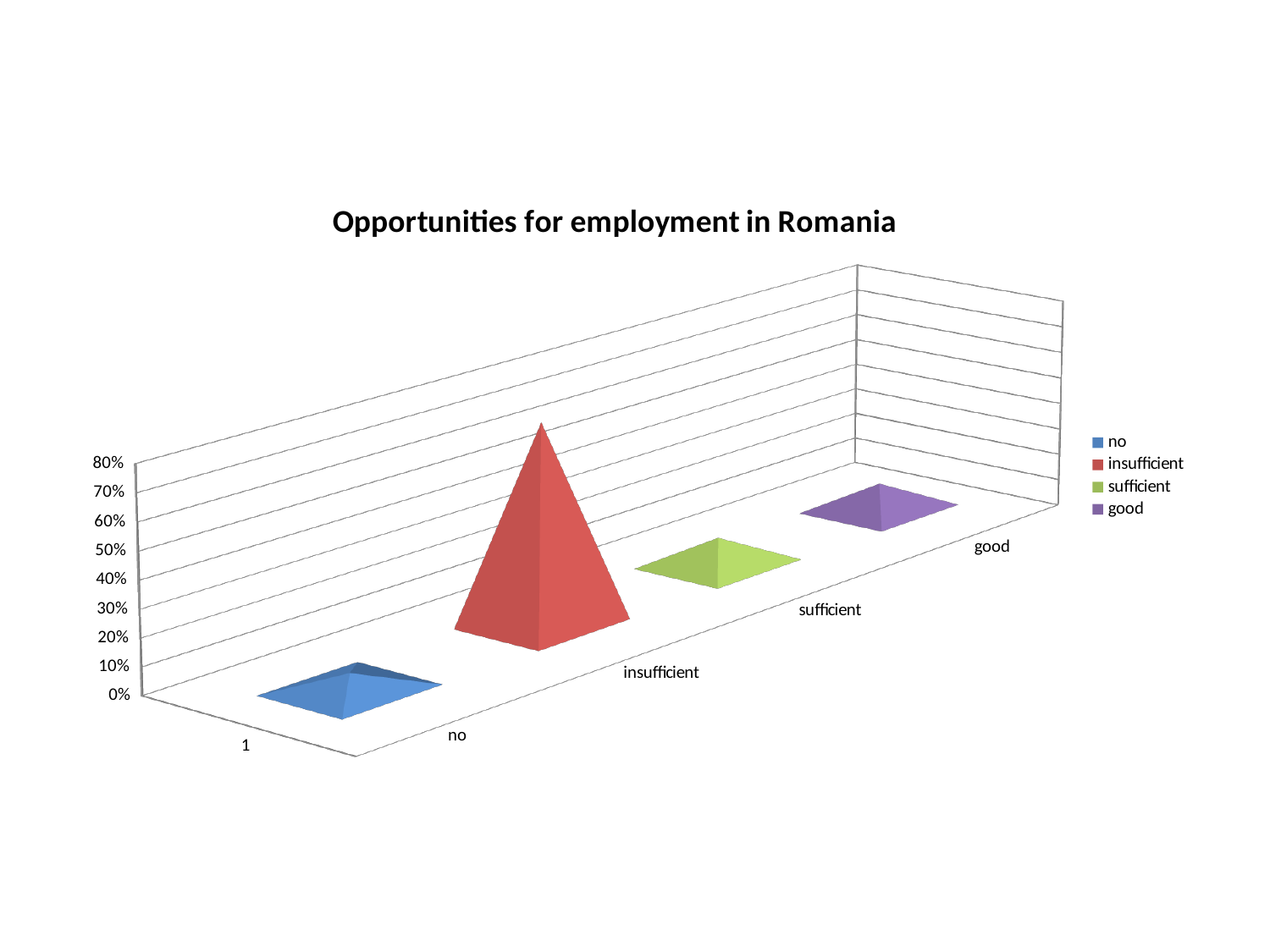
How many series does the legend list? 4 Is the value for sufficient greater or less than 30%? less Is the value for good greater or less than 30%? less What is the highest value shown on the vertical axis of the chart? 80% How many categories are shown along the x axis of the chart? 4 Which is larger, the value for insufficient or the value for no? insufficient Is the value for no greater or less than 30%? less What colour represents the 'insufficient' series in the legend? red Which is larger, the value for insufficient or the value for good? insufficient What is the title of the chart? Opportunities for employment in Romania Which category has the highest value in the chart? insufficient